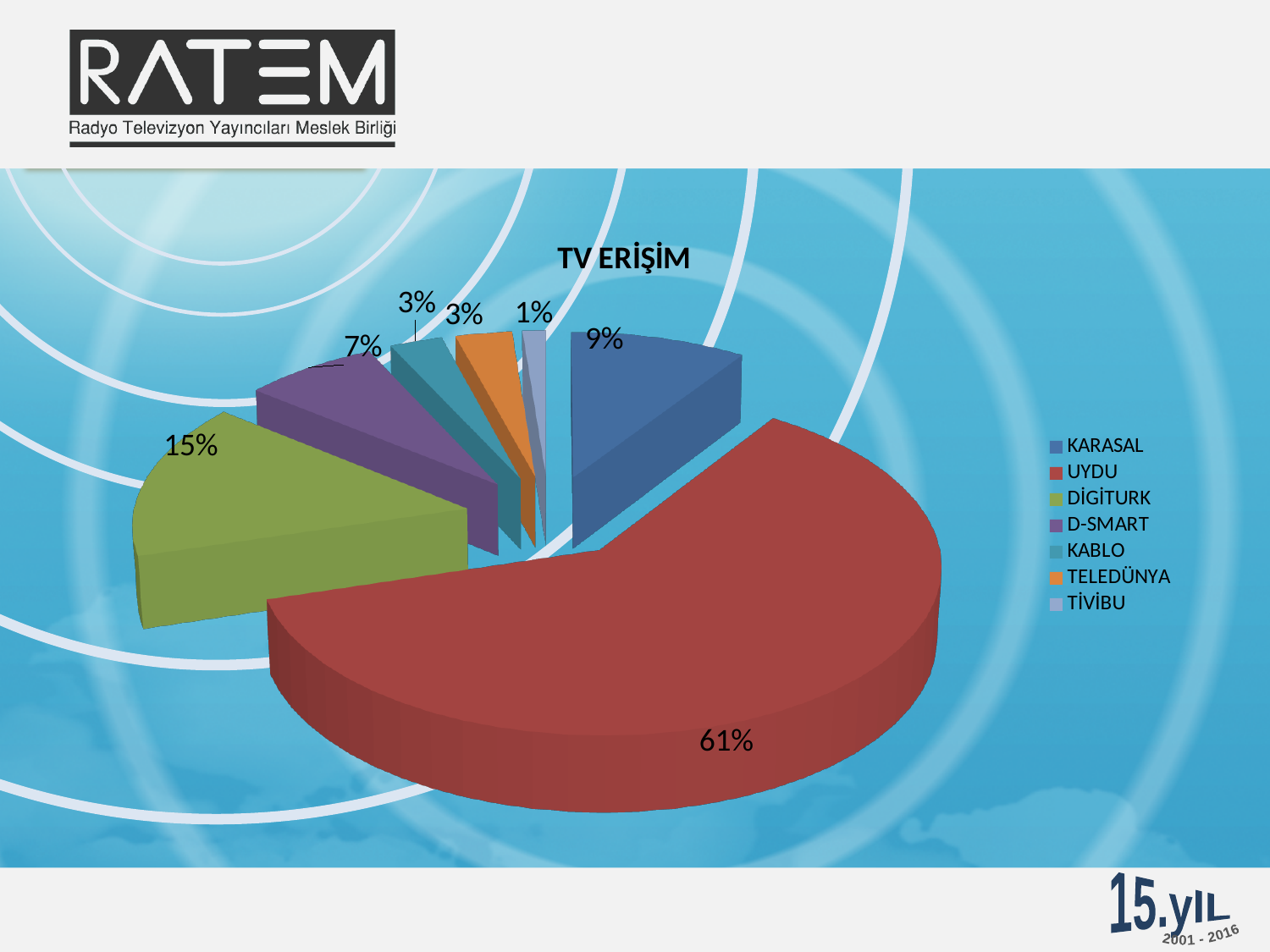
What share of the pie does KARASAL have? 9% What share of the pie does DİGİTURK have? 15% What share of the pie does UYDU have? 61% Which is larger, the share for KARASAL or the share for D-SMART? KARASAL What is the title of the chart? TV ERİŞİM How many categories does the legend list? 7 What kind of chart is shown on the slide? Pie chart Which category has the smallest slice of the pie? TİVİBU What is the difference in percentage points between UYDU and DİGİTURK? 46 Which category has the largest slice of the pie? UYDU